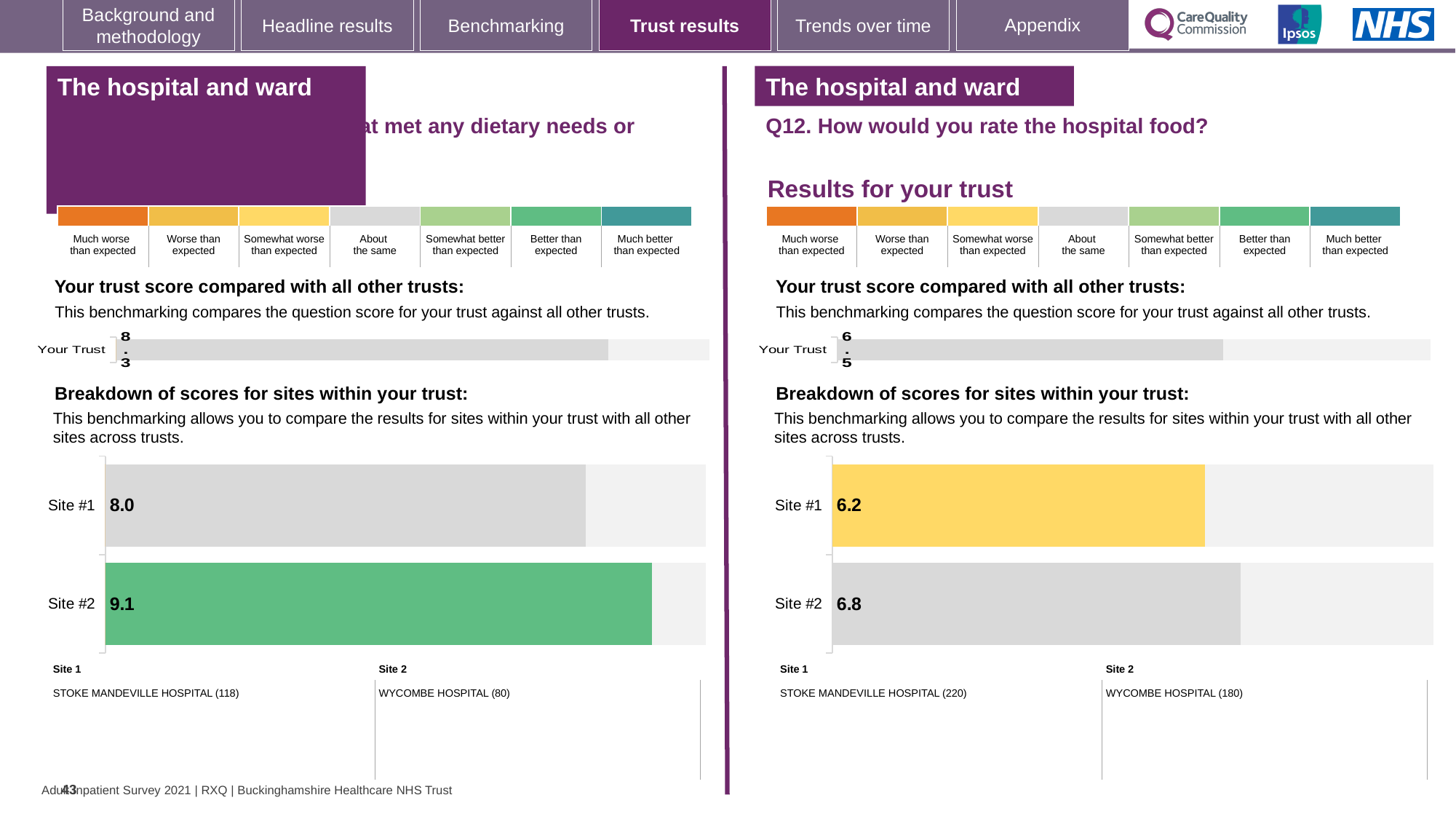
On the left-hand chart, what is the difference between the Site #2 and Site #1 scores? 1.1 On the left-hand chart, which site has the lower score? Site #1 On the left-hand chart, what is the score for Site #1? 8.0 On the right-hand chart (Q12, hospital food), what is the difference between the Site #2 and Site #1 scores? 0.6 On the right-hand chart (Q12, hospital food), what is the score for Site #1? 6.2 On the right-hand chart (Q12, hospital food), what is the 'Your Trust' score shown in the trust comparison bar? 6.5 On the left-hand chart, what is the 'Your Trust' score shown in the trust comparison bar? 8.3 On the right-hand chart (Q12, hospital food), what is the score for Site #2? 6.8 On the right-hand chart (Q12, hospital food), which site has the higher score? Site #2 How many sites are shown in the site breakdown chart on the right-hand side of the slide? 2 On the left-hand chart, what is the score for Site #2? 9.1 What type of chart is used for the breakdown of scores for sites on the right-hand side of the slide? Bar chart